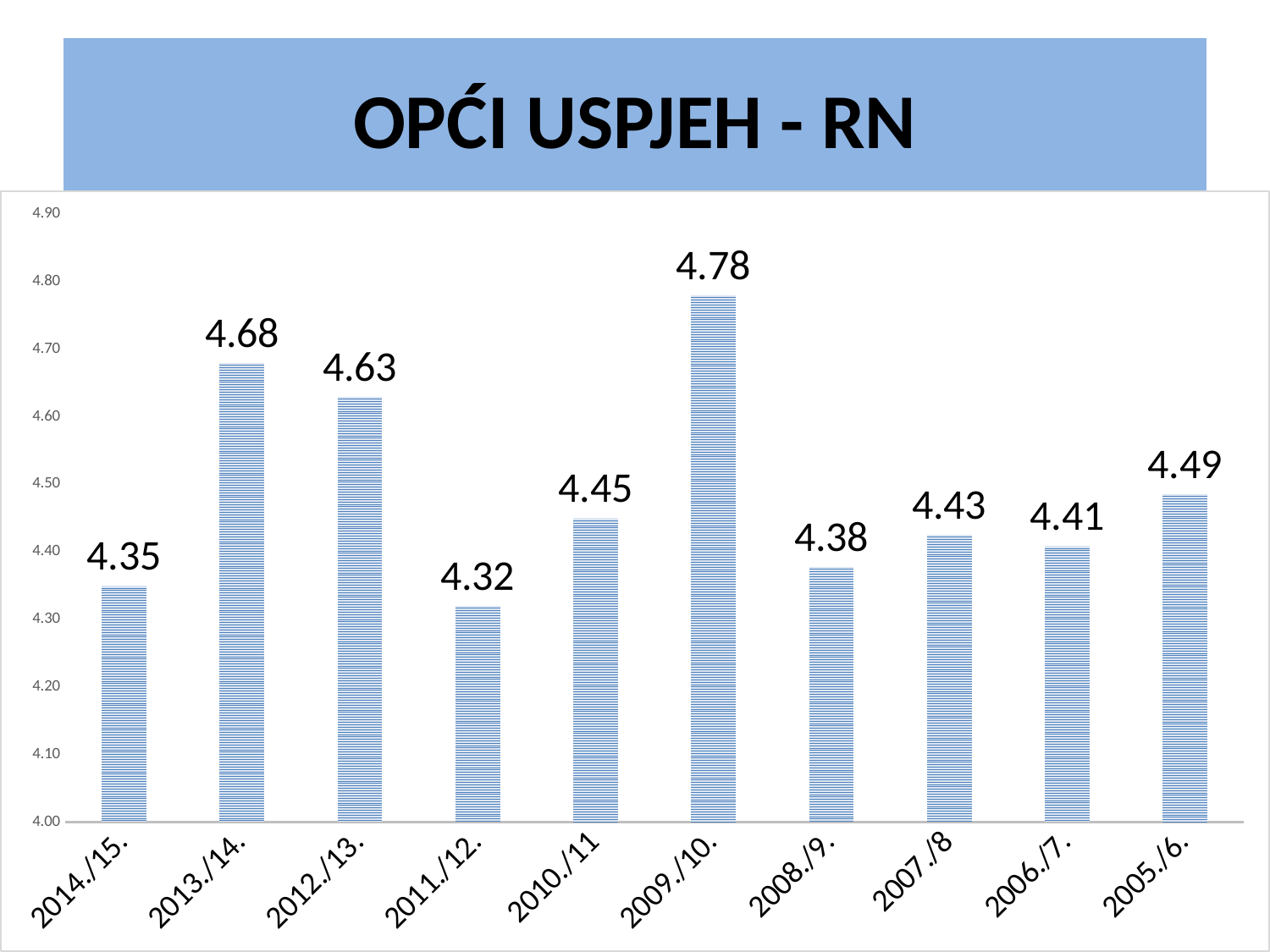
How many school years are shown on the chart? 10 Which school year has the highest value? 2009./10. Is the value for 2007./8 greater or less than 4.40? greater What is the value for 2009./10.? 4.78 What is the value for 2014./15.? 4.35 What kind of chart is shown on the slide? bar chart What is the title of the chart? OPĆI USPJEH - RN What is the value for 2005./6.? 4.49 Which school year has the lowest value? 2011./12. What is the difference between the values for 2013./14. and 2012./13.? 0.05 What is the difference between the values for 2009./10. and 2011./12.? 0.46 Which is larger, the value for 2010./11 or the value for 2008./9.? 2010./11